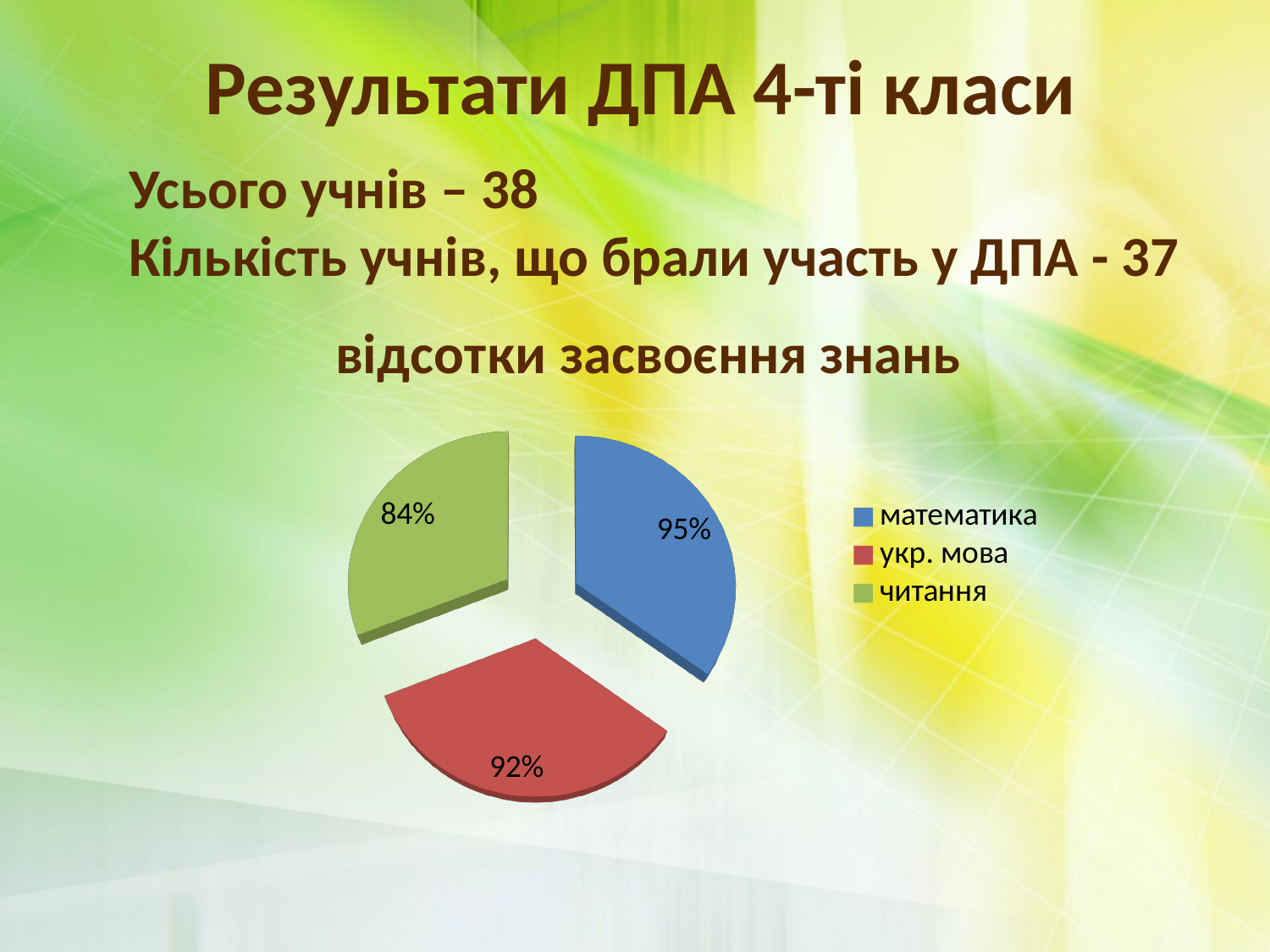
What type of chart is shown on the slide? pie chart What is the difference between the values for математика and читання? 11 percentage points Which is larger, the value for математика or the value for укр. мова? математика Which category has the highest value? математика What is the difference between the values for укр. мова and читання? 8 percentage points What is the value shown for математика? 95% Which category has the lowest value? читання What is the title of the chart? відсотки засвоєння знань How many slices does the pie chart have? 3 How many entries does the legend list? 3 What is the value shown for укр. мова? 92% What is the value shown for читання? 84%